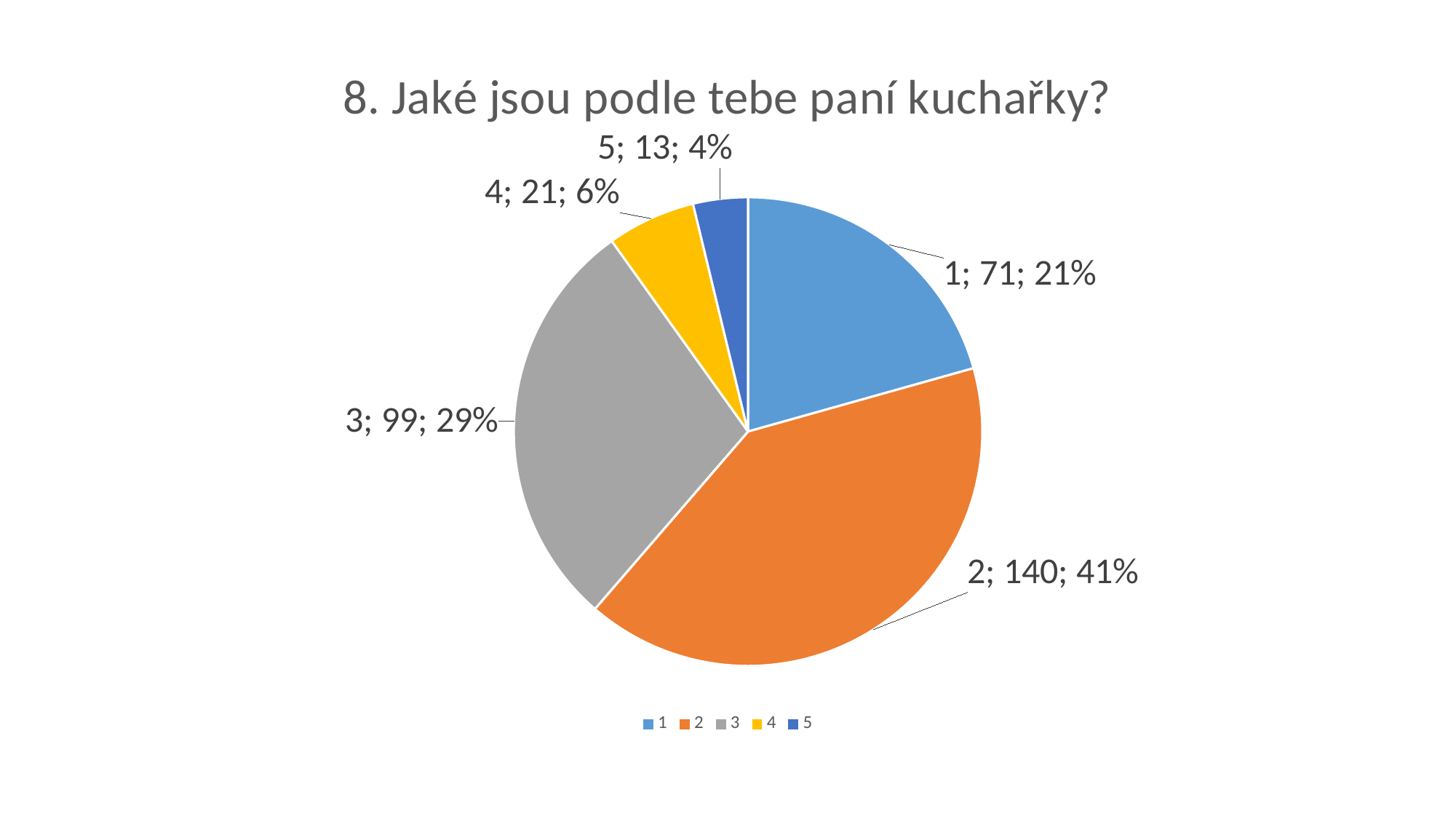
What is the value for category 5? 13 Which is larger, the value for category 1 or the value for category 4? 1 What is the difference between the values for category 2 and category 3? 41 What share of the pie does category 1 represent? 21% What is the title of the chart? 8. Jaké jsou podle tebe paní kuchařky? What kind of chart is shown on the slide? pie chart How many slices does the pie chart have? 5 What is the value for category 2? 140 Which category has the largest slice? 2 What share of the pie does category 4 represent? 6% Which category has the smallest slice? 5 What is the value for category 3? 99